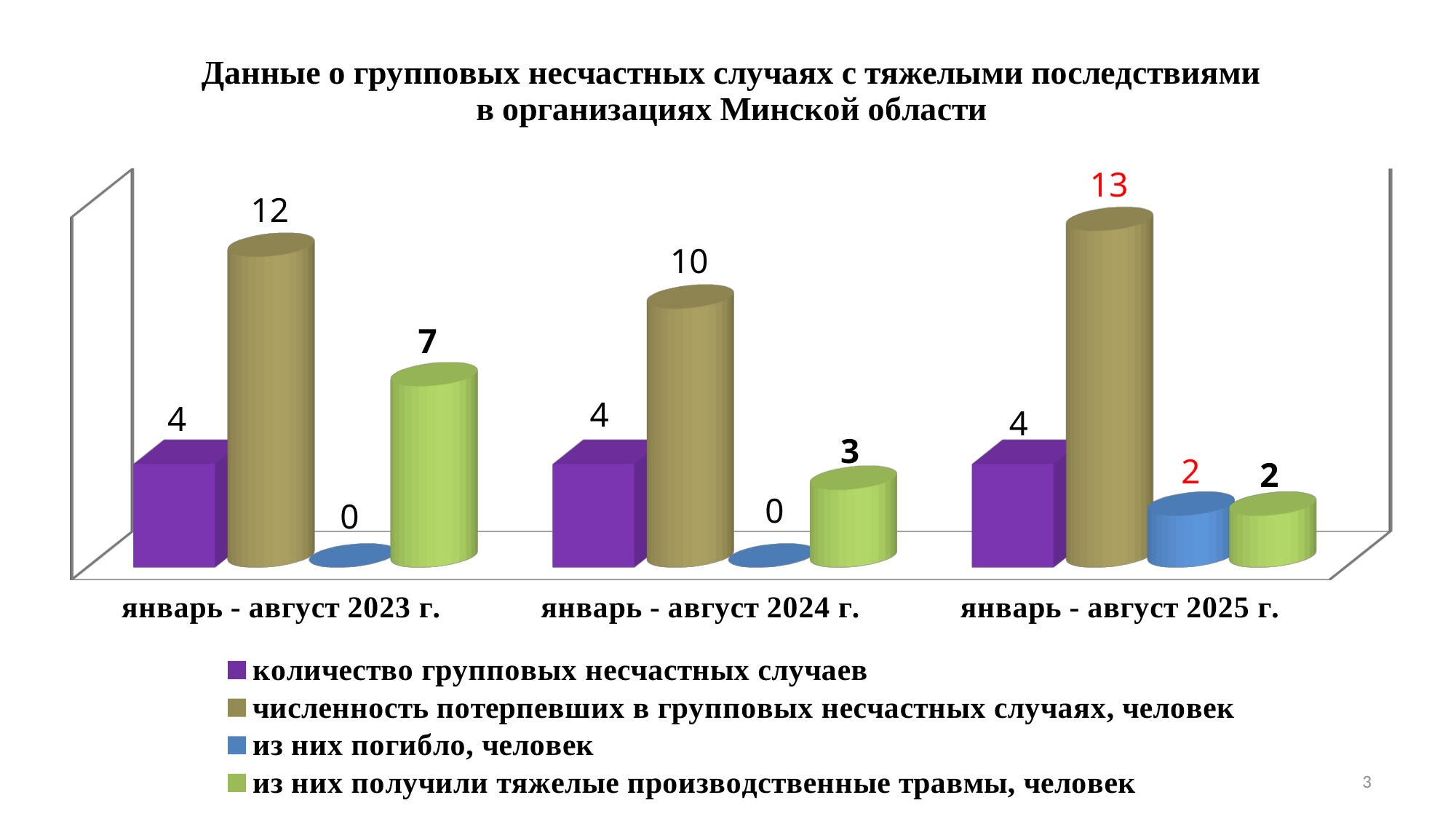
Which series is shown in purple in the legend? количество групповых несчастных случаев What is the difference between "численность потерпевших в групповых несчастных случаях, человек" for январь - август 2025 г. and январь - август 2024 г.? 3 How many periods are shown on the x axis? 3 What is the value of "из них получили тяжелые производственные травмы, человек" for январь - август 2023 г.? 7 Which is larger: "из них получили тяжелые производственные травмы, человек" for январь - август 2023 г. or for январь - август 2024 г.? январь - август 2023 г. What kind of chart is shown on the slide? bar chart What is the value of "численность потерпевших в групповых несчастных случаях, человек" for январь - август 2025 г.? 13 In which period is "численность потерпевших в групповых несчастных случаях, человек" the highest? январь - август 2025 г. In which period is "численность потерпевших в групповых несчастных случаях, человек" the lowest? январь - август 2024 г. How many series does the legend list? 4 What is the value of "из них погибло, человек" for январь - август 2024 г.? 0 What is the value of "количество групповых несчастных случаев" for январь - август 2025 г.? 4